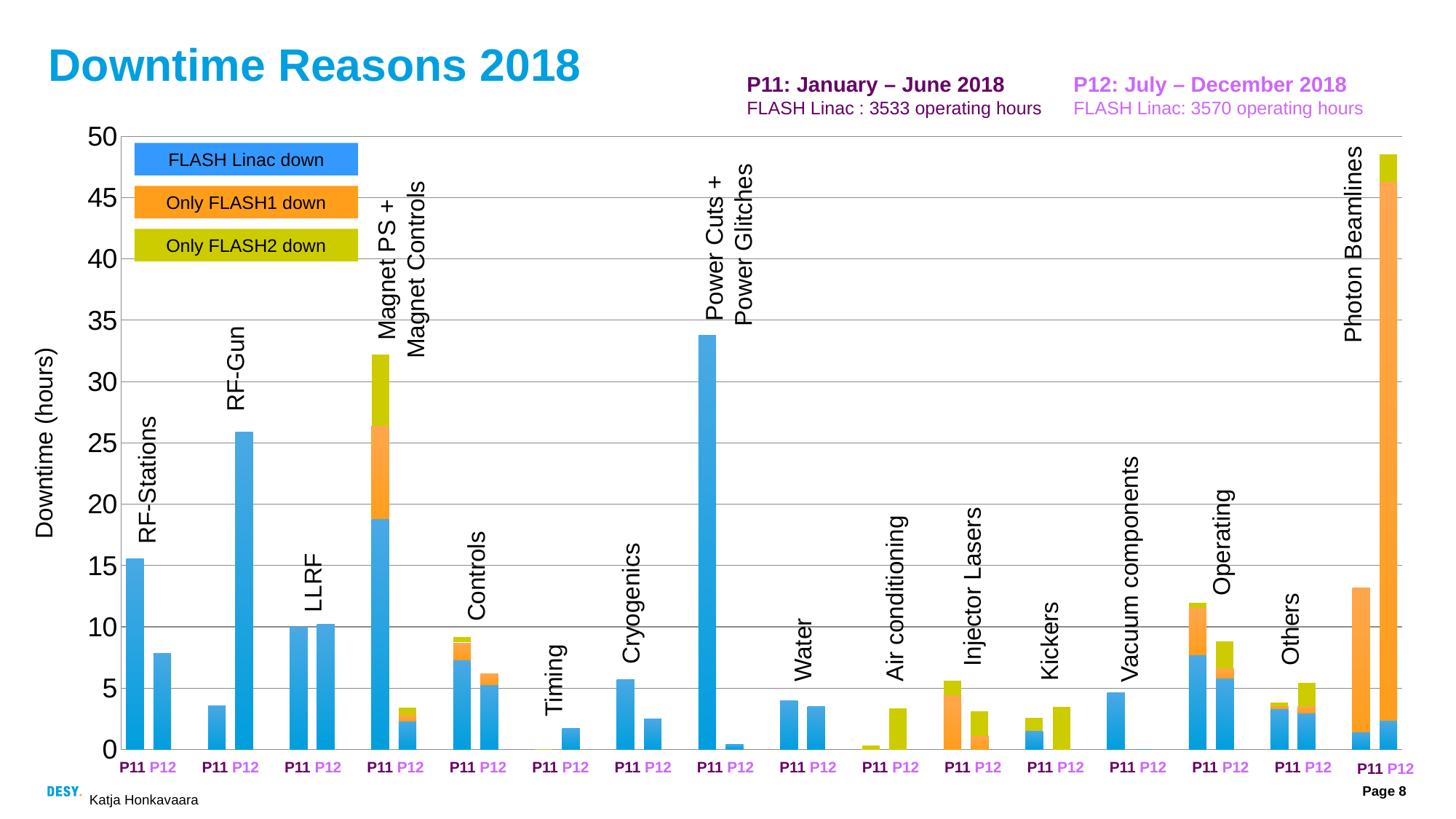
Is the P11 bar for Power Cuts + Power Glitches greater or less than 30 hours? greater How many downtime reason categories are shown along the x axis? 16 Which is larger, the P11 bar for RF-Stations or the P12 bar for RF-Stations? P11 Is the P11 bar for Magnet PS + Magnet Controls greater or less than 30 hours? greater How many series does the legend list? 3 Which is larger, the P11 bar for RF-Gun or the P11 bar for LLRF? LLRF P11 What kind of chart is shown on the slide? Stacked bar chart Is the P12 bar for Photon Beamlines greater or less than 45 hours? greater Which category has the tallest bar in the chart? Photon Beamlines (P12) What is the label of the y axis? Downtime (hours)